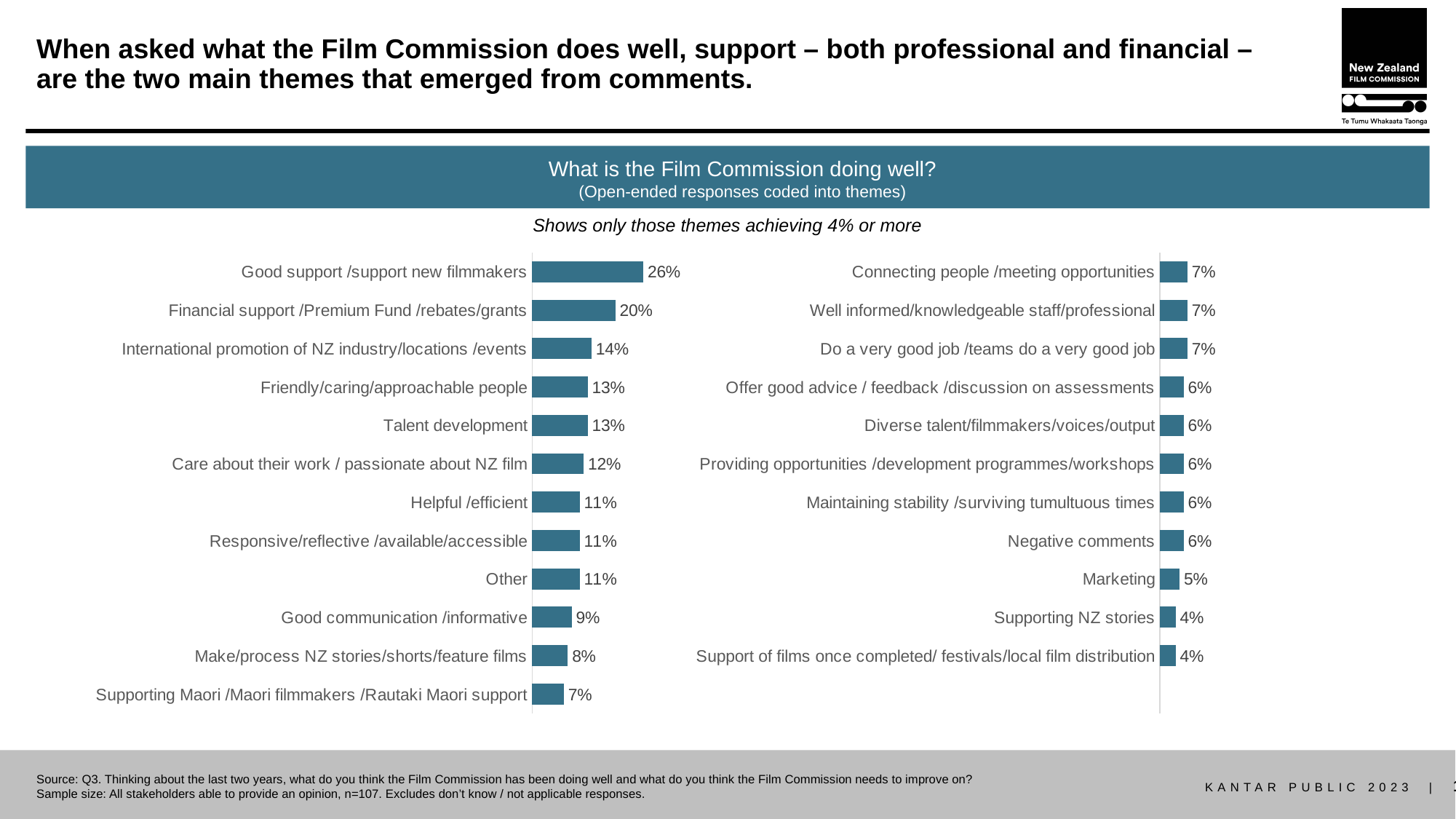
What type of chart is used on this slide? Bar chart In the left chart, which theme has the highest percentage? Good support /support new filmmakers How many themes are shown in the left chart? 12 In the right chart, what percentage is shown for Marketing? 5% In the left chart, what percentage is shown for International promotion of NZ industry/locations /events? 14% How many themes are shown in the right chart? 11 In the right chart, what is the difference between Connecting people /meeting opportunities and Supporting NZ stories? 3 percentage points In the left chart, what is the difference between Good support /support new filmmakers and Financial support /Premium Fund /rebates/grants? 6 percentage points In the left chart, which is larger: Good communication /informative or Make/process NZ stories/shorts/feature films? Good communication /informative In the left chart, which theme has the lowest percentage? Supporting Maori /Maori filmmakers /Rautaki Maori support In the right chart, what percentage is shown for Negative comments? 6% In the left chart, what percentage is shown for Good support /support new filmmakers? 26%